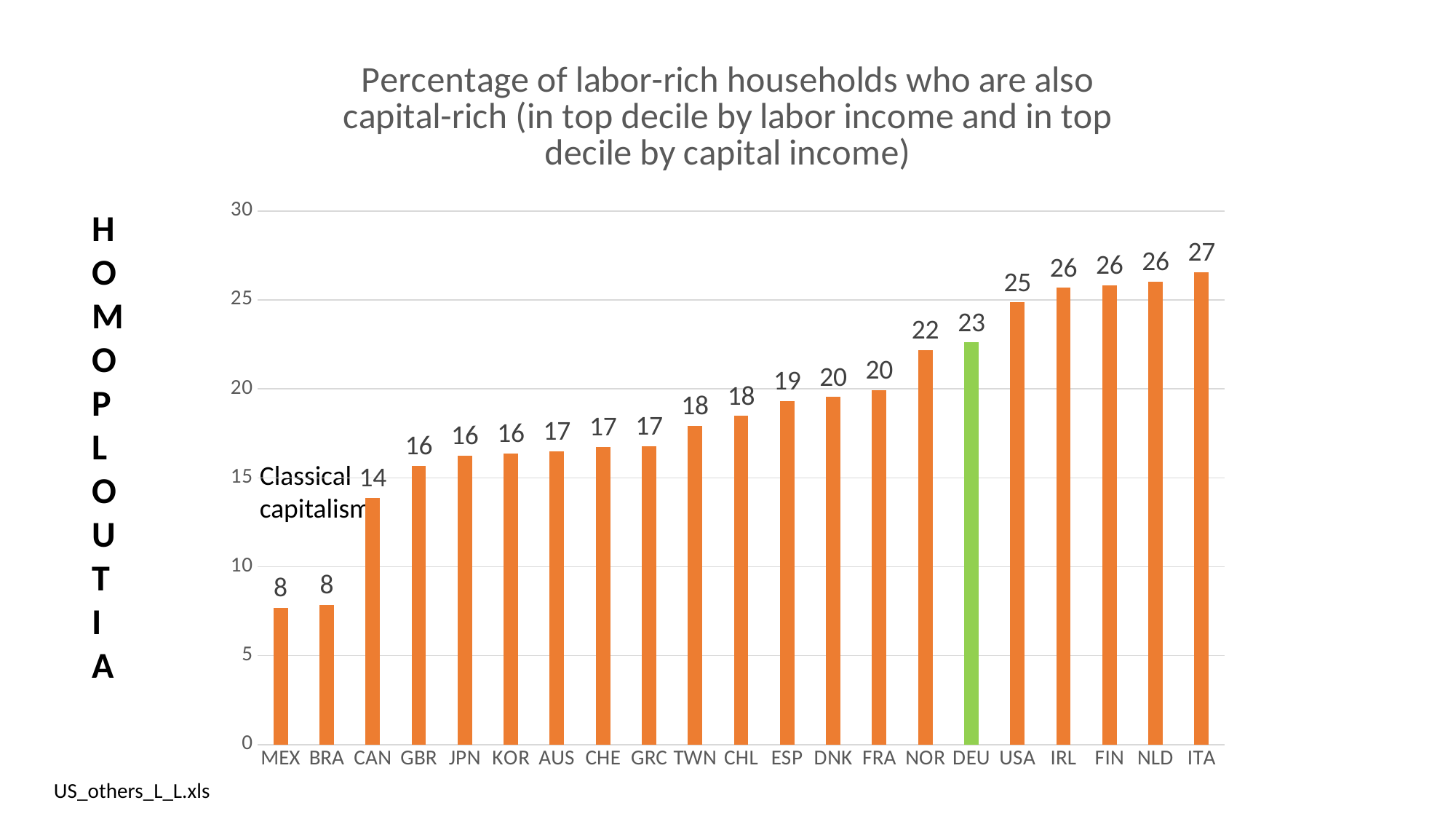
Do the values rise or fall from left to right along the x axis? rise Which country's bar is coloured green instead of orange? DEU How many countries are shown on the x axis? 21 Is the value for NOR greater or less than 20? greater Which country has the highest value? ITA Which has a larger value, USA or FRA? USA What is the difference between the values for ITA and MEX? 19 What is the value for DEU? 23 What kind of chart is this? bar chart What is the difference between the values for USA and CAN? 11 What is the value for CAN? 14 What is the value for USA? 25